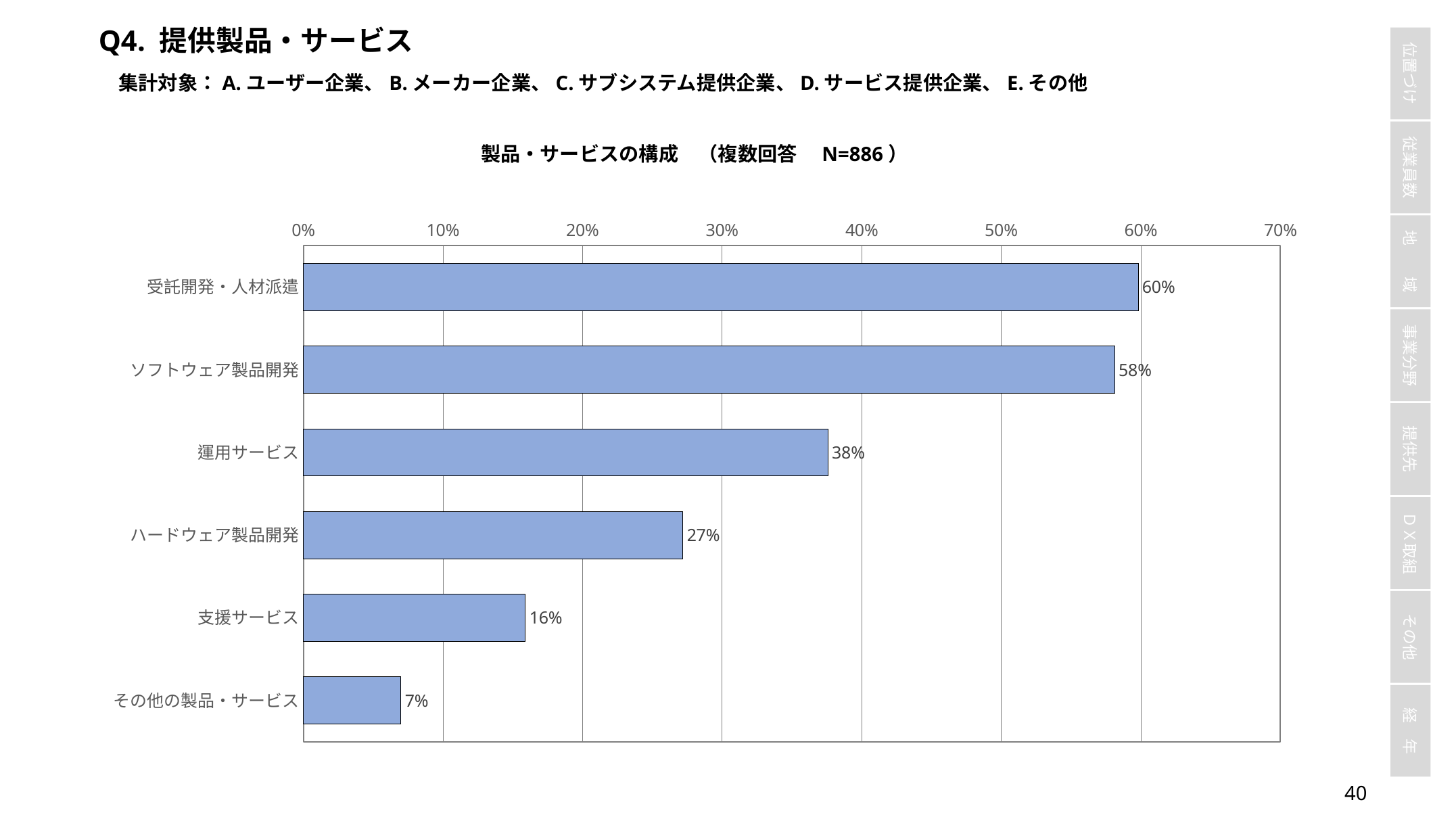
What is the difference between the values for ソフトウェア製品開発 and ハードウェア製品開発? 31% Is the value for ハードウェア製品開発 greater or less than 30%? less What kind of chart is shown on the slide? bar chart Which category has the lowest value? その他の製品・サービス How many categories are shown in the chart? 6 What is the value for 運用サービス? 38% What is the value for 支援サービス? 16% What is the title of the chart? 製品・サービスの構成 （複数回答 N=886） What is the maximum value shown on the horizontal axis? 70% What is the value for 受託開発・人材派遣? 60% Which is larger, the value for 運用サービス or the value for 支援サービス? 運用サービス Which category has the highest value? 受託開発・人材派遣